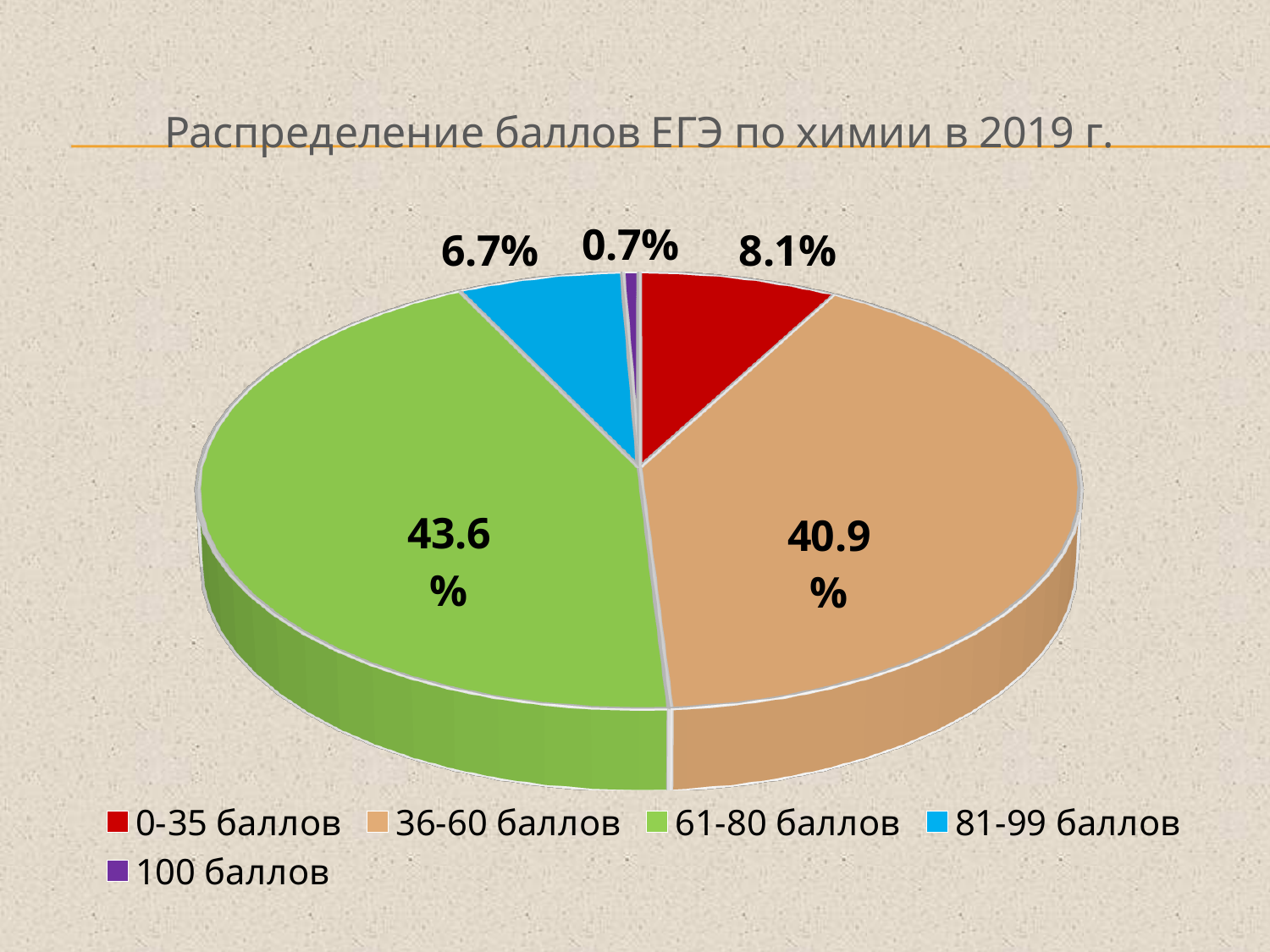
What is the title of the chart? Распределение баллов ЕГЭ по химии в 2019 г. What share of the pie is labelled for the 81-99 баллов slice? 6.7% Which slice is larger: 0-35 баллов or 81-99 баллов? 0-35 баллов What is the difference between the shares of the 61-80 баллов and 36-60 баллов slices? 2.7% What share of the pie is labelled for the 36-60 баллов slice? 40.9% Which category has the largest slice of the pie? 61-80 баллов What type of chart is shown on the slide? Pie chart What share of the pie is labelled for the 0-35 баллов slice? 8.1% How many categories does the legend list? 5 Which category has the smallest slice of the pie? 100 баллов